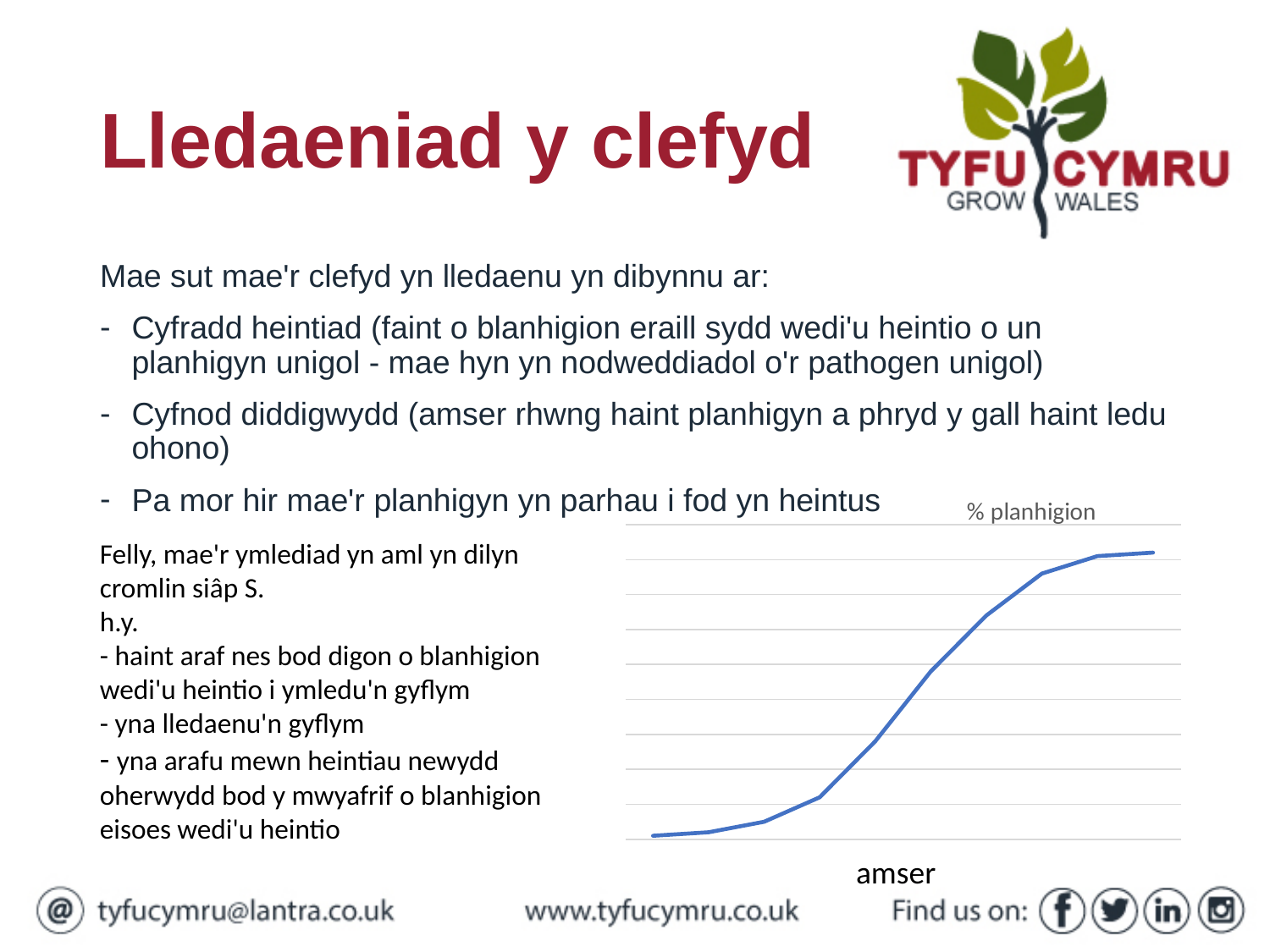
How many lines are plotted on the chart? 1 What label is shown on the vertical axis of the chart? % planhigion What kind of chart is shown on the slide? line chart What label is shown on the horizontal axis of the chart? amser Is the plotted line steeper in the middle of the chart or at the two ends? in the middle Does the plotted line rise or fall as it moves along the x axis (amser)? rise